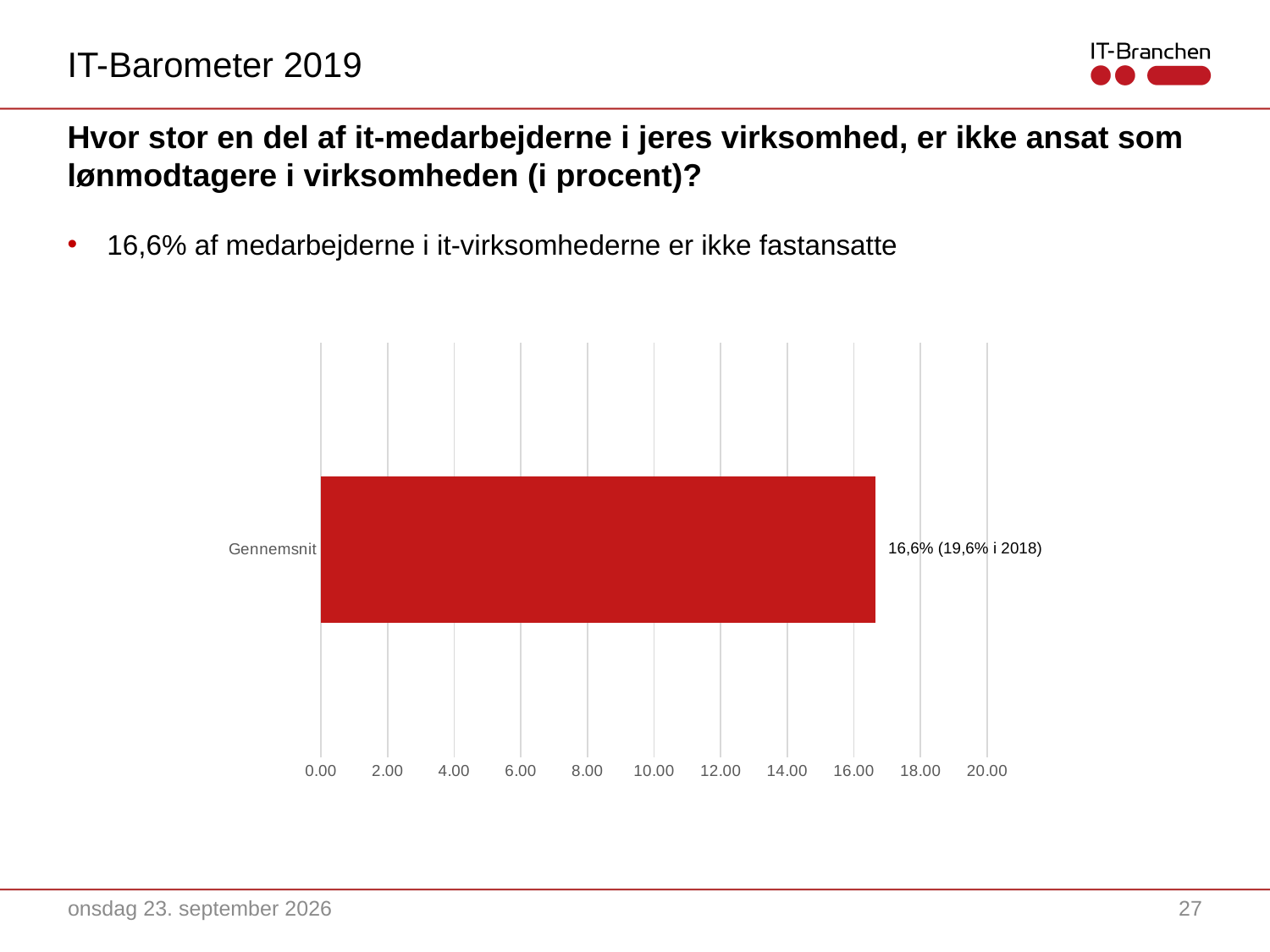
What is the value shown for Gennemsnit in the chart? 16,6% According to the data label on the bar, what was the value in 2018? 19,6% By how much did the value for Gennemsnit fall from 2018 (19,6%) to 2019 (16,6%)? 3,0 percentage points What is the highest tick value shown on the chart's horizontal axis? 20.00 What is the label of the single category on the chart's vertical axis? Gennemsnit What colour is the bar in the chart? Red Is the value for Gennemsnit greater or less than 18.00 on the axis? less How many categories are plotted in the chart? 1 Is the value for Gennemsnit greater or less than 16.00 on the axis? greater What kind of chart is shown on the slide? Bar chart Which is larger: the 2019 value (16,6%) or the 2018 value (19,6%) shown in the data label? 2018 value (19,6%)